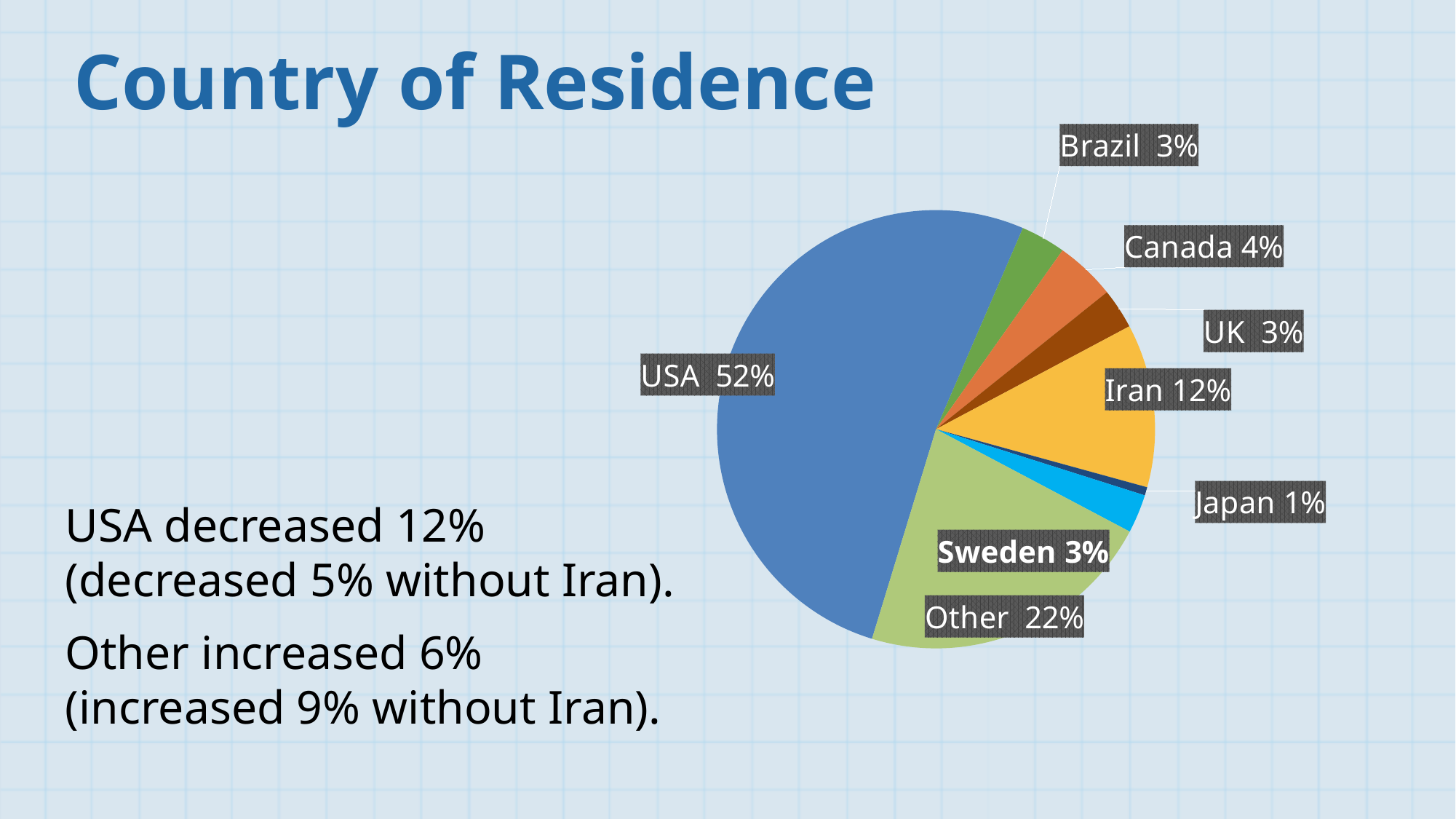
Which category has the largest slice of the pie? USA What share of the pie does USA account for? 52% What is the difference between the Iran and Canada shares? 8% Which category has the smallest slice of the pie? Japan What is the value for Canada? 4% Which is larger, the share for Iran or the share for Other? Other What is the difference between the USA and Other shares? 30% What is the value for Iran? 12% What is the value for Other? 22% How many categories are shown in the pie chart? 8 What kind of chart is shown on the slide? Pie chart What is the value for Japan? 1%